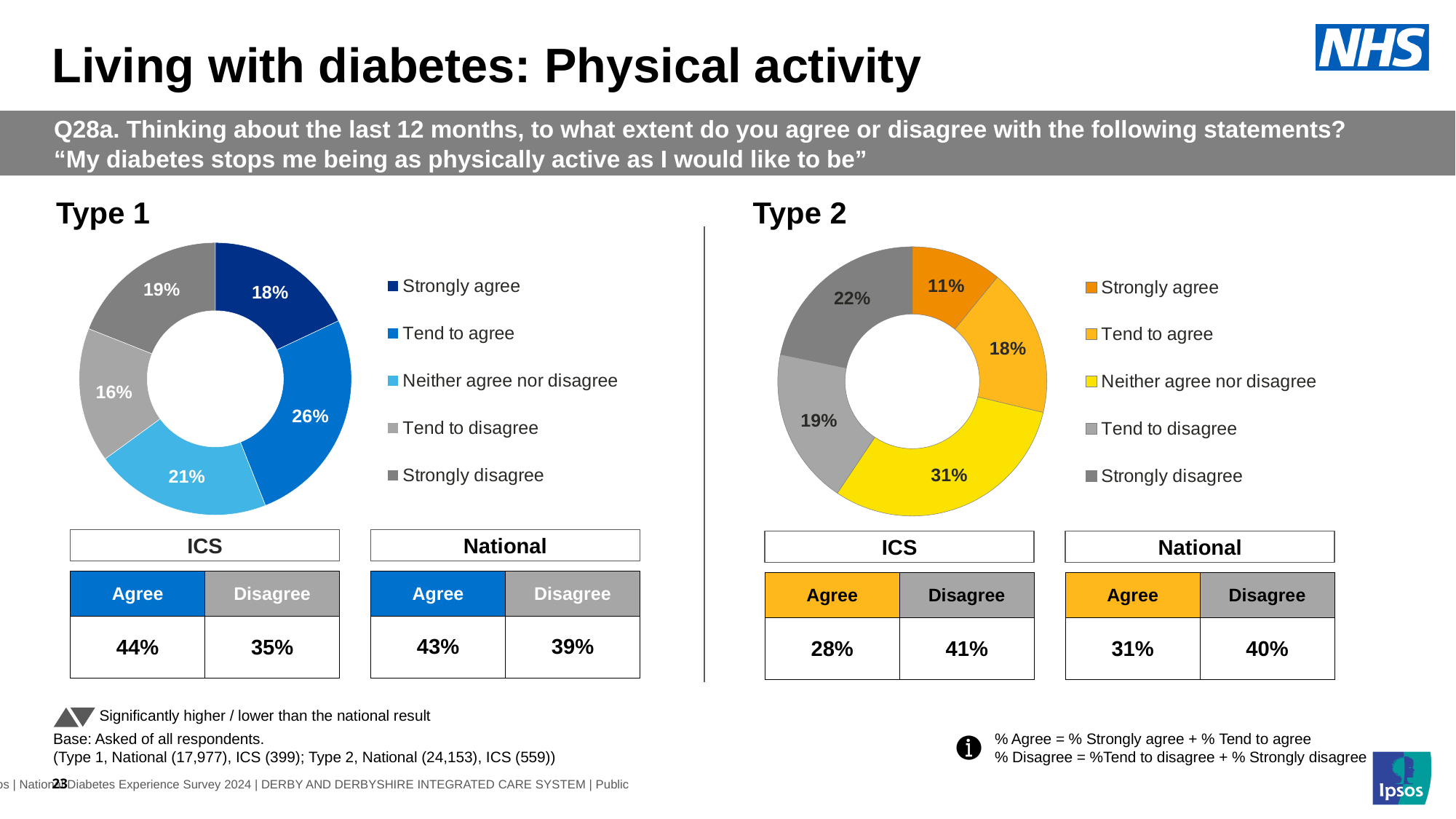
In the Type 1 chart, which is larger: Strongly agree or Neither agree nor disagree? Neither agree nor disagree In the Type 2 chart, what percentage strongly agree? 11% In the Type 2 chart, what percentage of respondents said they neither agree nor disagree? 31% In the Type 2 chart, which response category has the smallest share? Strongly agree In the Type 2 chart, what colour represents Neither agree nor disagree? Yellow In the Type 1 chart, what percentage strongly disagree? 19% What kind of chart is used for Type 1? Donut (pie) chart In the Type 1 chart, which response category has the largest share? Tend to agree In the Type 1 chart, what percentage of respondents said they tend to agree? 26% How many response categories does the Type 2 chart's legend list? 5 In the Type 2 chart, what is the difference between the Strongly disagree and Strongly agree shares? 11% In the Type 1 chart, which response category has the smallest share? Tend to disagree